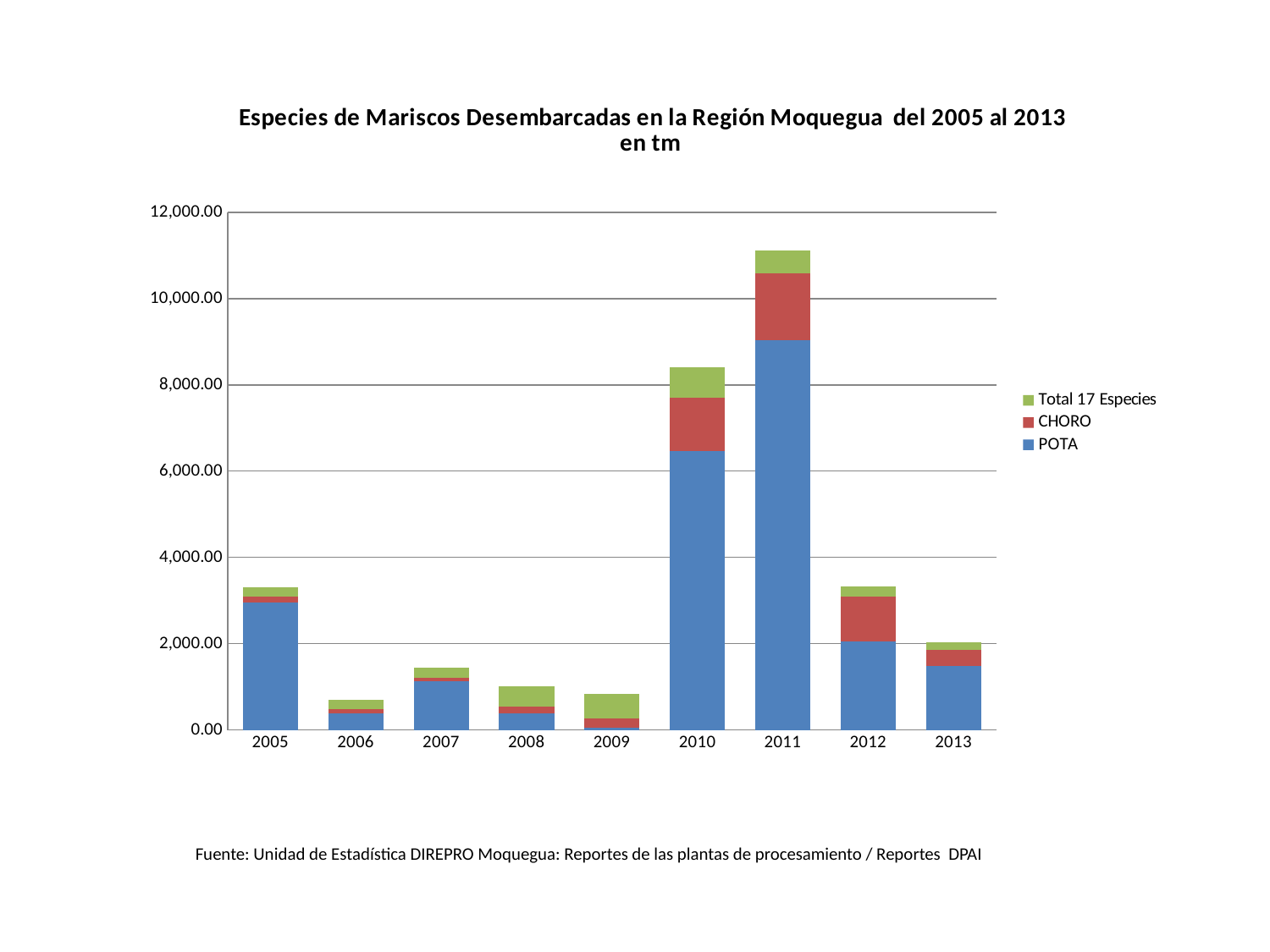
Is the total stacked bar for 2011 greater or less than 10,000.00? greater Is the total stacked bar for 2010 greater or less than 8,000.00? greater How many series does the legend list? 3 What kind of chart is shown on the slide? Stacked bar chart Which series is shown in green in the legend? Total 17 Especies Which year has the lowest POTA value? 2009 Which year has the highest total stacked bar? 2011 How many years are shown on the x axis of the chart? 9 Which year has the larger total stacked bar, 2010 or 2012? 2010 Do the total stacked bars rise or fall from 2011 to 2013? fall Is the POTA value for 2010 greater or less than 6,000.00? greater Which year has the highest POTA value? 2011